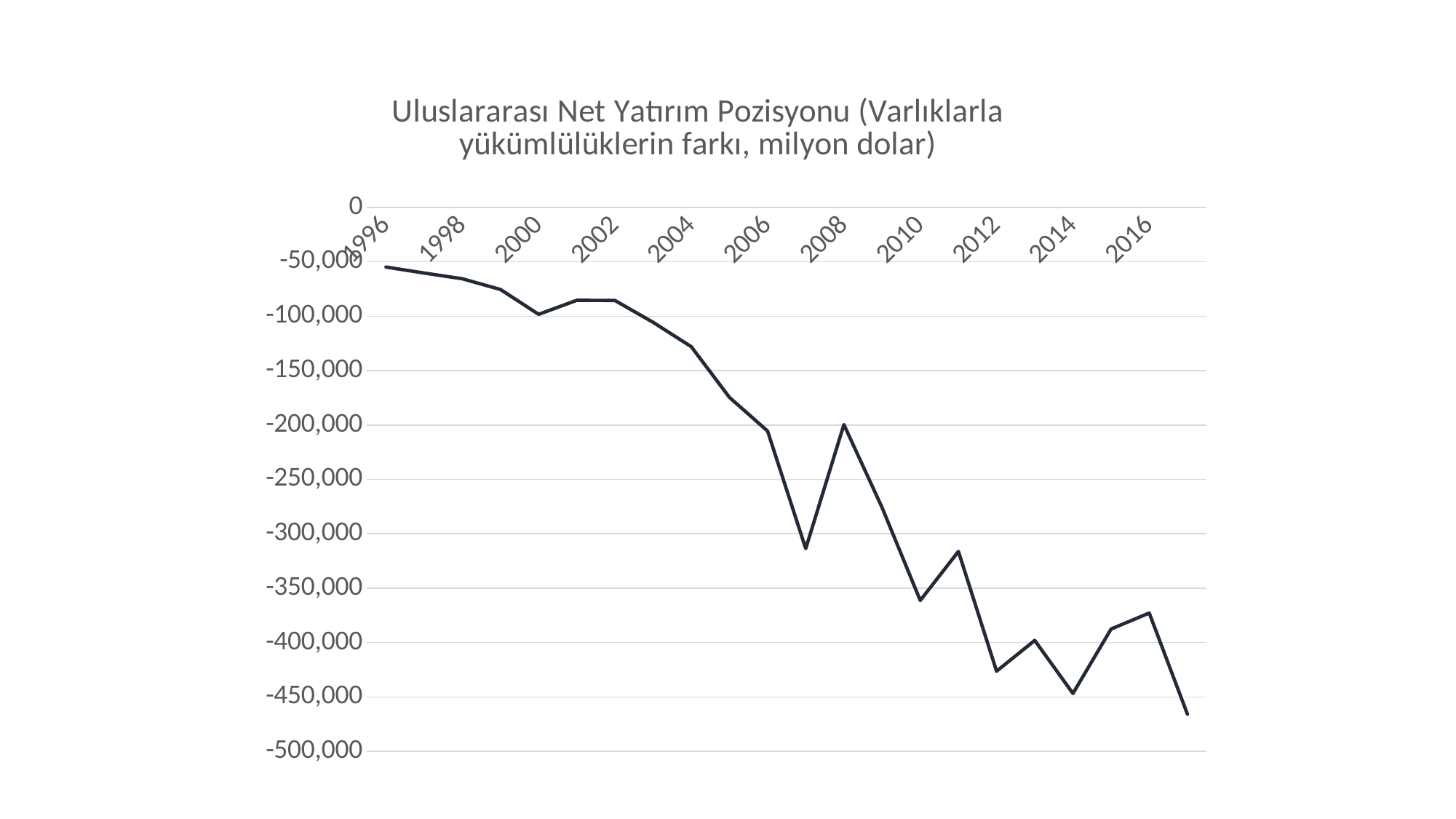
Which year has the larger value, 2008 or 2010? 2008 What kind of chart is shown on the slide? line chart Is the value for 2016 greater or less than -400,000? greater Which labelled year on the x axis has the lowest (most negative) value? 2014 Is the value for 2008 greater or less than -250,000? greater Is the value for 2004 greater or less than -150,000? greater What is the title of the chart? Uluslararası Net Yatırım Pozisyonu (Varlıklarla yükümlülüklerin farkı, milyon dolar) How many year labels are shown on the x axis? 11 Which labelled year on the x axis has the highest (least negative) value? 1996 Overall, do the values rise or fall from 1996 to the end of the series? fall